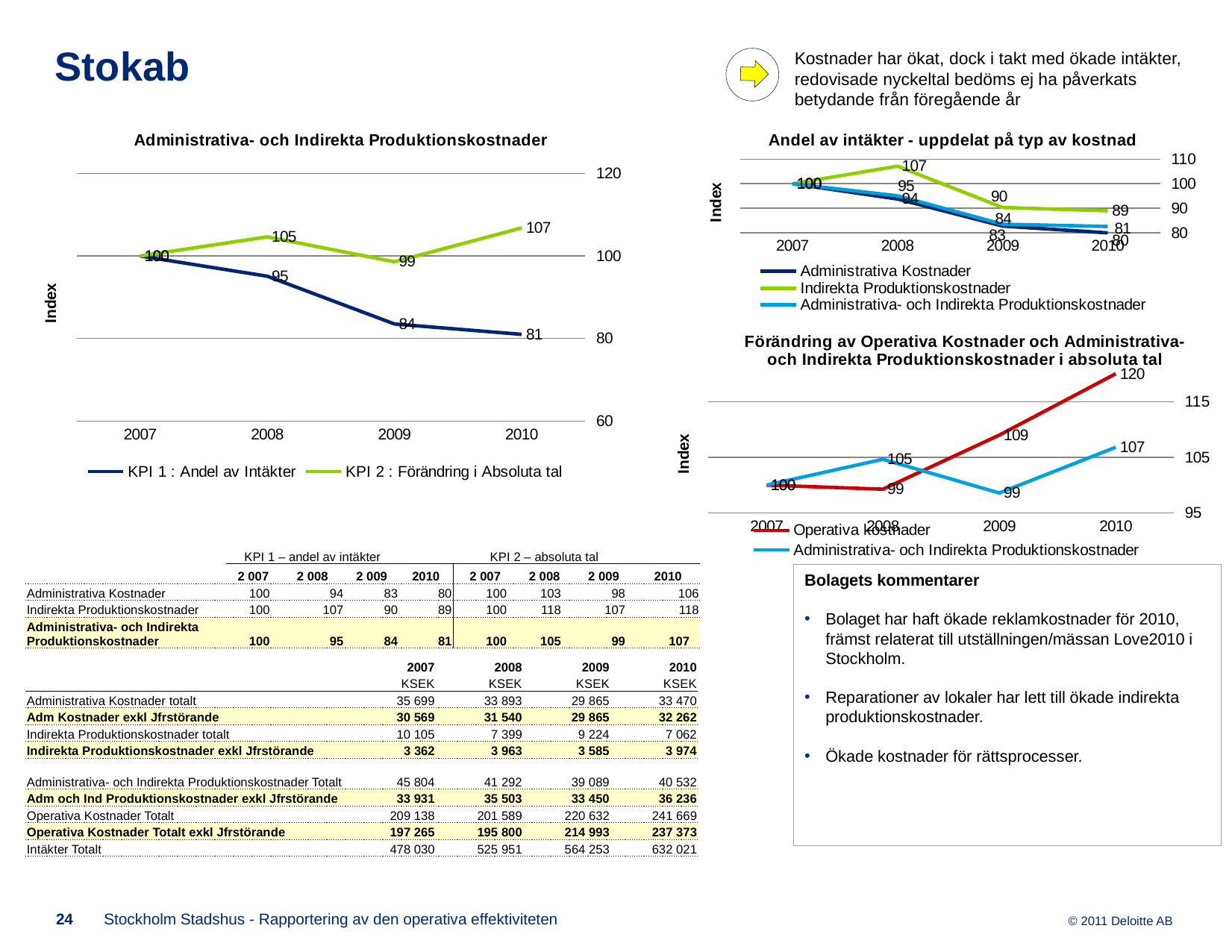
How many years are shown on the x axis of the chart 'Förändring av Operativa Kostnader och Administrativa- och Indirekta Produktionskostnader i absoluta tal'? 4 In the chart 'Administrativa- och Indirekta Produktionskostnader', does KPI 1 : Andel av Intäkter rise or fall from 2007 to 2010? fall In the chart 'Administrativa- och Indirekta Produktionskostnader', in which year is KPI 1 : Andel av Intäkter lowest? 2010 In the chart 'Förändring av Operativa Kostnader och Administrativa- och Indirekta Produktionskostnader i absoluta tal', what is the value of Operativa kostnader in 2010? 120 In the chart 'Administrativa- och Indirekta Produktionskostnader', what is the value of KPI 2 : Förändring i Absoluta tal in 2008? 105 In the chart 'Administrativa- och Indirekta Produktionskostnader', what is the difference between KPI 2 and KPI 1 in 2010? 26 What type of chart is 'Andel av intäkter - uppdelat på typ av kostnad'? line chart In the chart 'Administrativa- och Indirekta Produktionskostnader', what is the value of KPI 1 : Andel av Intäkter in 2010? 81 How many series does the legend of the chart 'Administrativa- och Indirekta Produktionskostnader' list? 2 How many series does the legend of the chart 'Andel av intäkter - uppdelat på typ av kostnad' list? 3 In the chart 'Förändring av Operativa Kostnader och Administrativa- och Indirekta Produktionskostnader i absoluta tal', which series has the higher value in 2009, Operativa kostnader or Administrativa- och Indirekta Produktionskostnader? Operativa kostnader In the chart 'Andel av intäkter - uppdelat på typ av kostnad', what is the value of Indirekta Produktionskostnader in 2008? 107